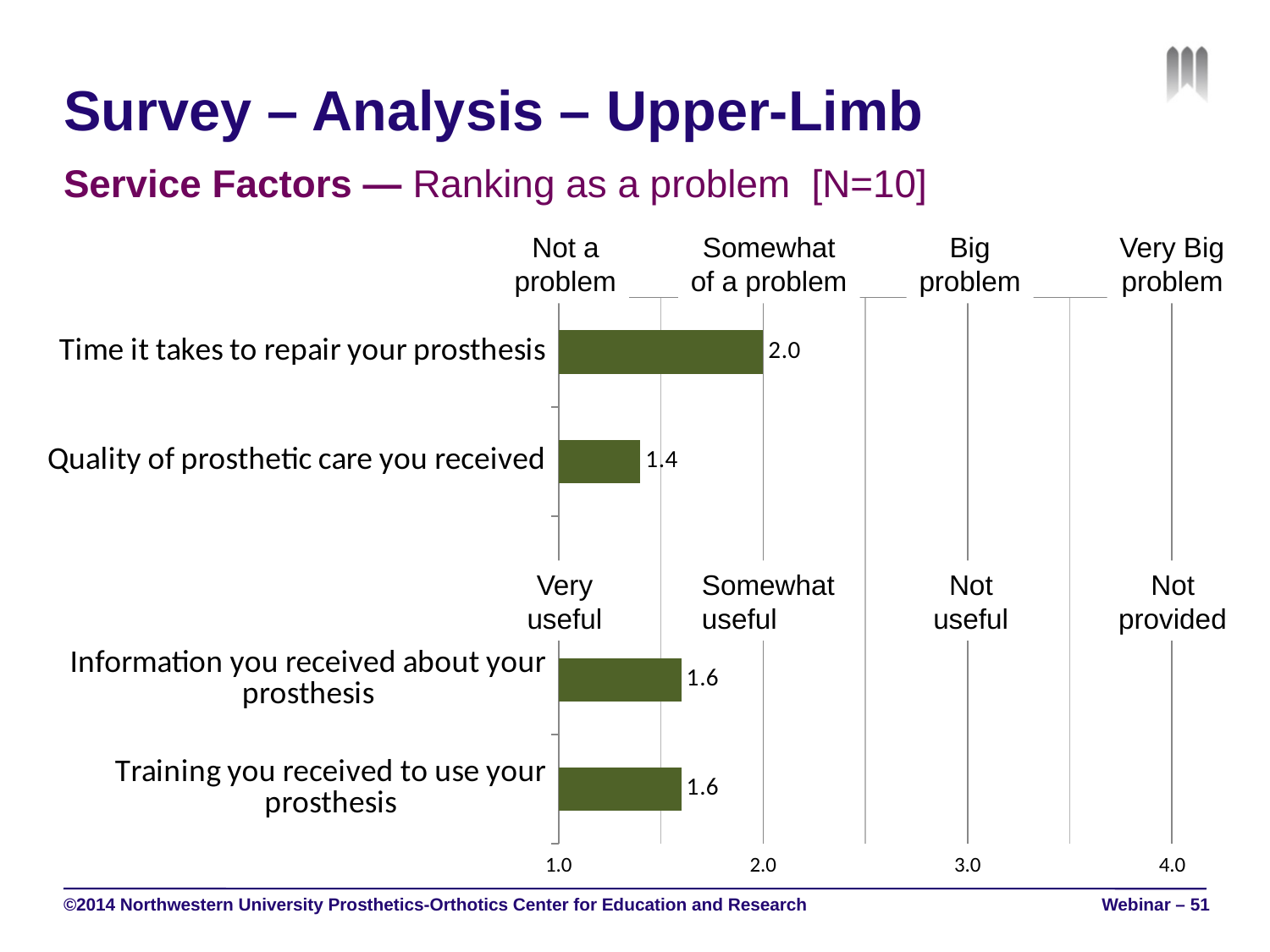
Which is larger: the value for "Time it takes to repair your prosthesis" or the value for "Information you received about your prosthesis"? Time it takes to repair your prosthesis What kind of chart is shown on the slide? Bar chart Which category has the highest value? Time it takes to repair your prosthesis What is the difference between the values for "Time it takes to repair your prosthesis" and "Quality of prosthetic care you received"? 0.6 What is the highest value shown on the chart's x axis? 4.0 What is the value for "Training you received to use your prosthesis"? 1.6 Which category has the lowest value? Quality of prosthetic care you received What is the value for "Time it takes to repair your prosthesis"? 2.0 What is the value for "Information you received about your prosthesis"? 1.6 How many categories (bars) are shown in the chart? 4 What is the value for "Quality of prosthetic care you received"? 1.4 Is the value for "Quality of prosthetic care you received" greater or less than 2.0? less